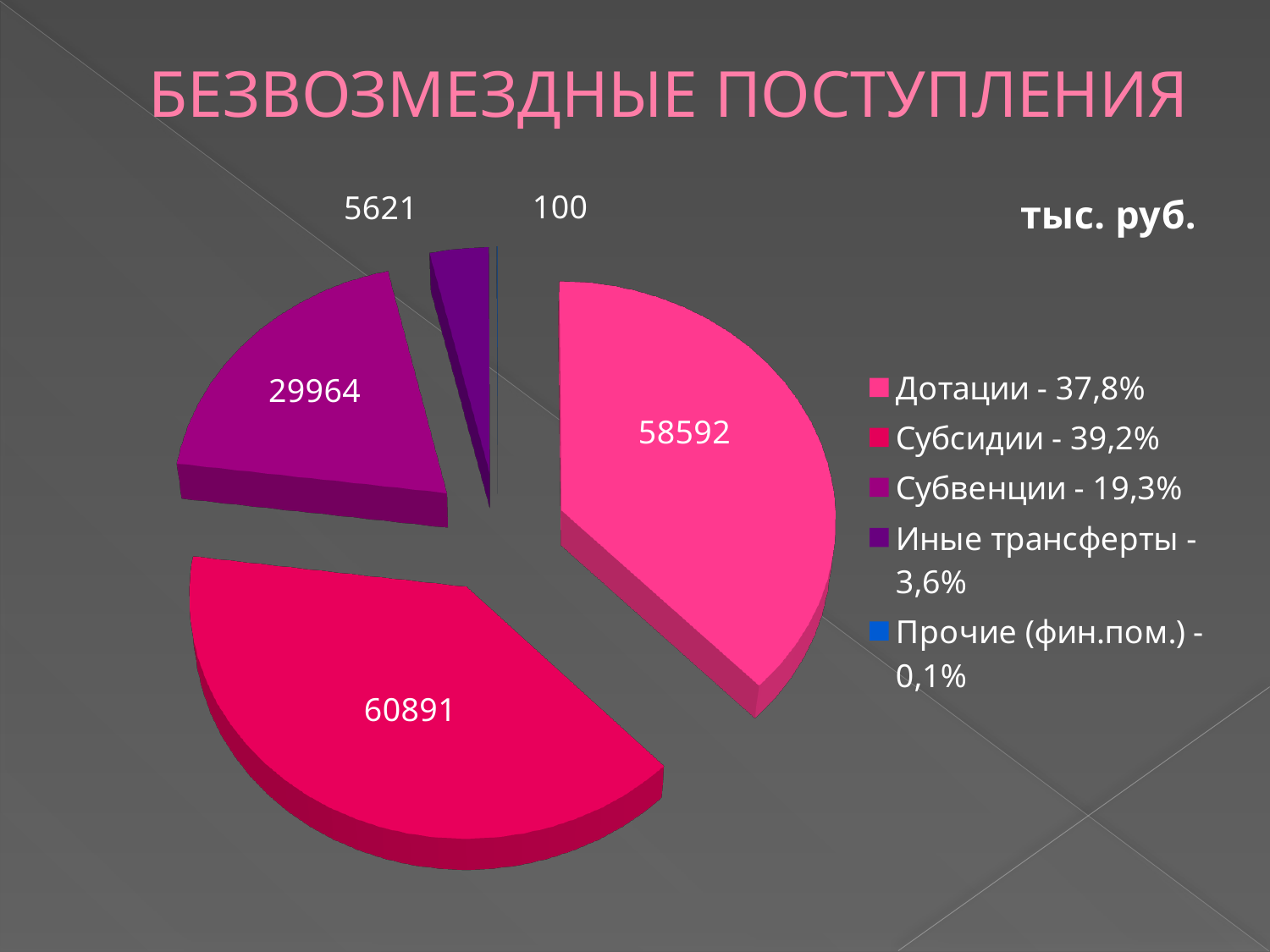
What is the value for Дотации? 58592 What is the value for Прочие (фин.пом.)? 100 What is the value for Субсидии? 60891 What share of the pie does Субвенции represent, according to the legend? 19,3% What is the value for Иные трансферты? 5621 What is the difference between the values for Субсидии and Дотации? 2299 What kind of chart is shown on the slide? pie chart Which category has the smallest value? Прочие (фин.пом.) What is the difference between the values for Субвенции and Иные трансферты? 24343 Which category has the largest value? Субсидии What is the value for Субвенции? 29964 How many categories does the legend list? 5